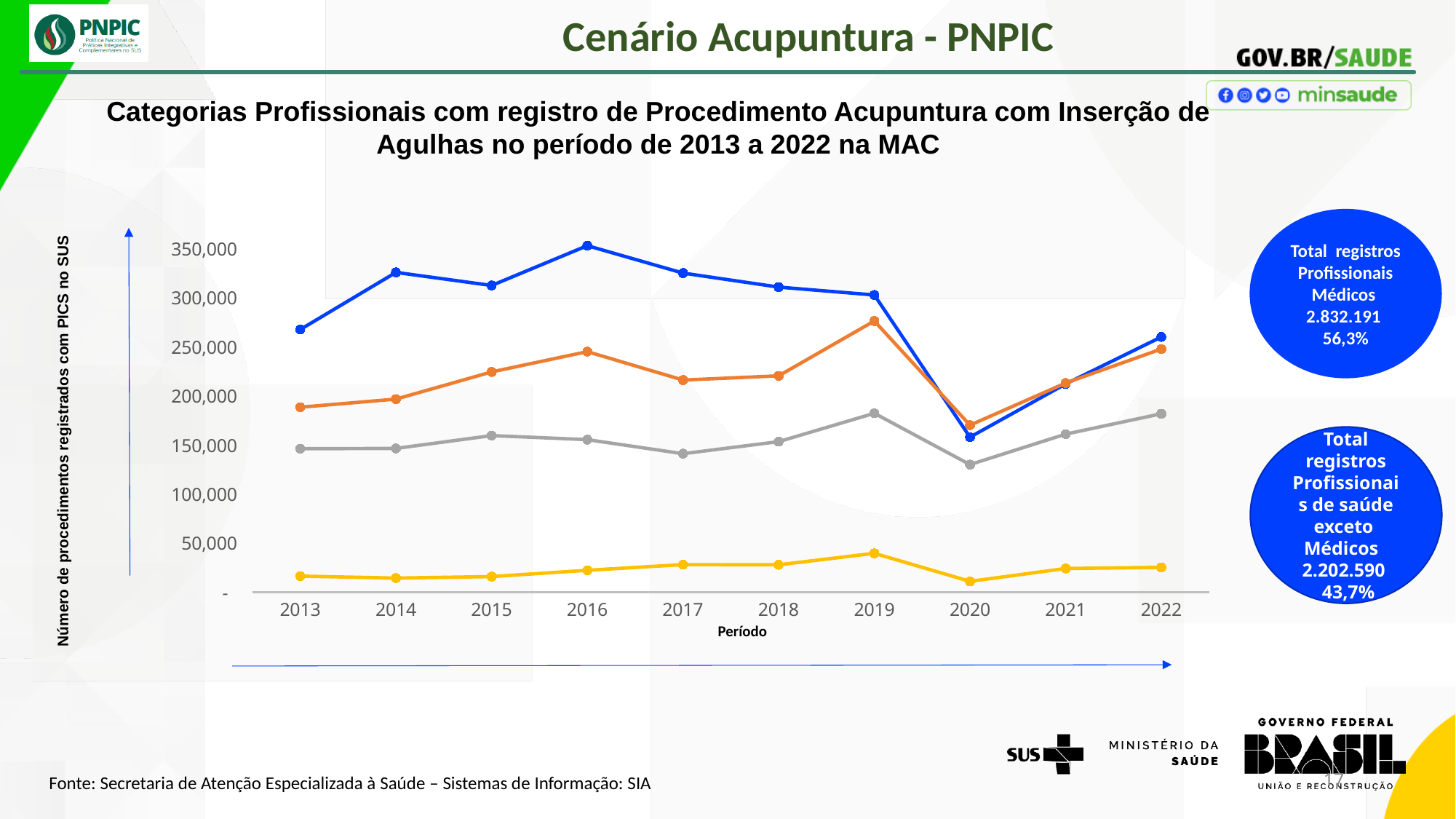
In 2013, which line has the larger value, the blue line or the orange line? blue line Is the value of the yellow line in 2019 greater or less than 50,000? less Does the blue line rise or fall between 2019 and 2020? fall Is the value of the blue line in 2020 greater or less than 200,000? less In which year does the blue line reach its highest value? 2016 Is the value of the blue line in 2016 greater or less than 300,000? greater What kind of chart is shown on the slide? line chart In which year does the blue line reach its lowest value? 2020 How many years are plotted along the x axis of the chart? 10 In which year does the orange line reach its highest value? 2019 In which year does the gray line reach its lowest value? 2020